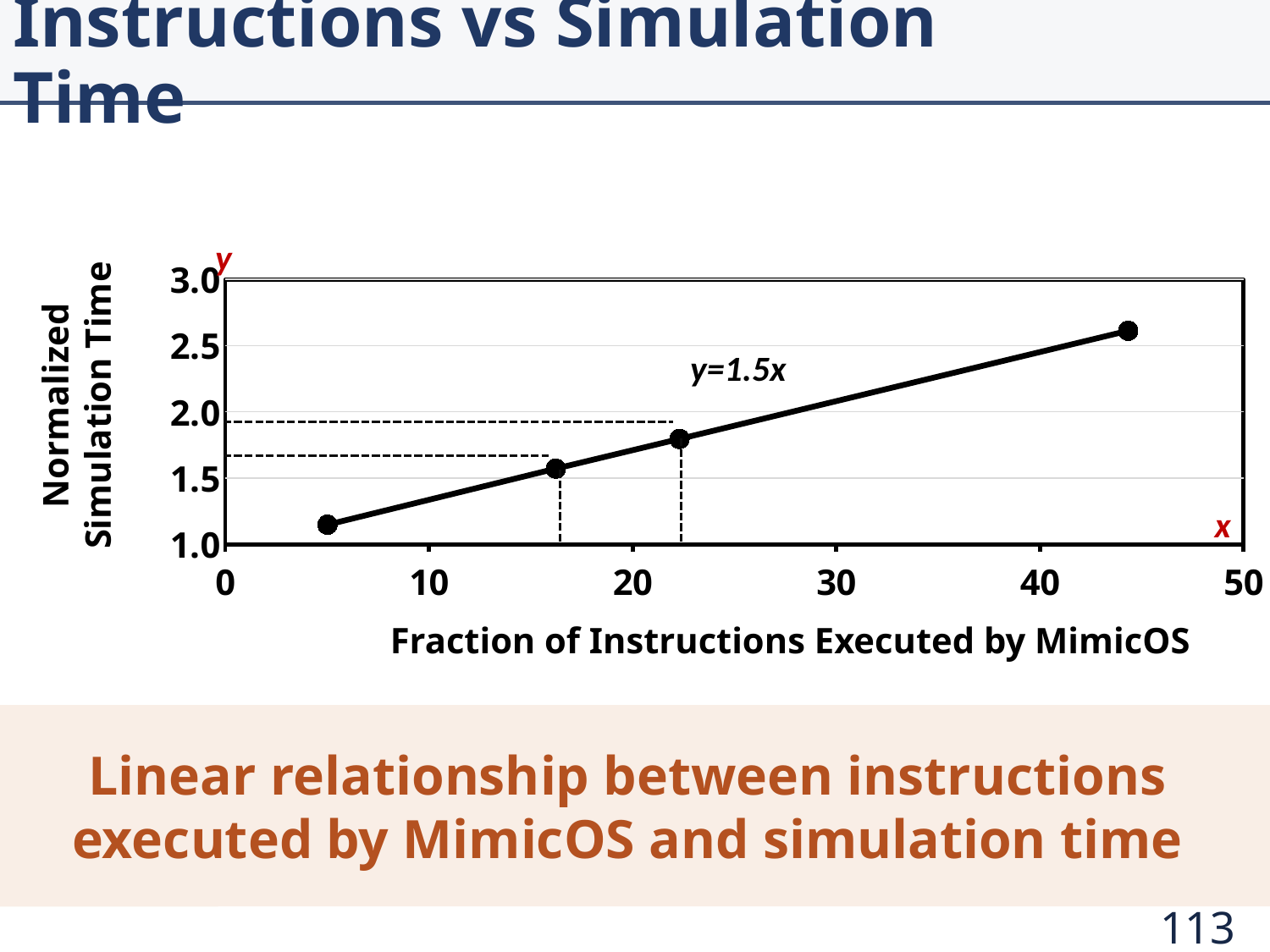
What is the label of the x axis? Fraction of Instructions Executed by MimicOS Is the normalized simulation time for the rightmost data point (near x=44) greater or less than 2.0? greater Does the normalized simulation time rise or fall as the fraction of instructions executed by MimicOS increases? Rise What kind of chart is shown on the slide? Scatter chart with a trend line What equation is printed next to the trend line on the chart? y=1.5x How many data points are plotted on the chart? 4 Is the normalized simulation time for the data point near x=22 greater or less than 2.0? less What is the highest value shown on the y axis? 3.0 Is the normalized simulation time for the data point near x=16 greater or less than 1.5? greater Which data point has the highest normalized simulation time: the one near x=5 or the one near x=44? The one near x=44